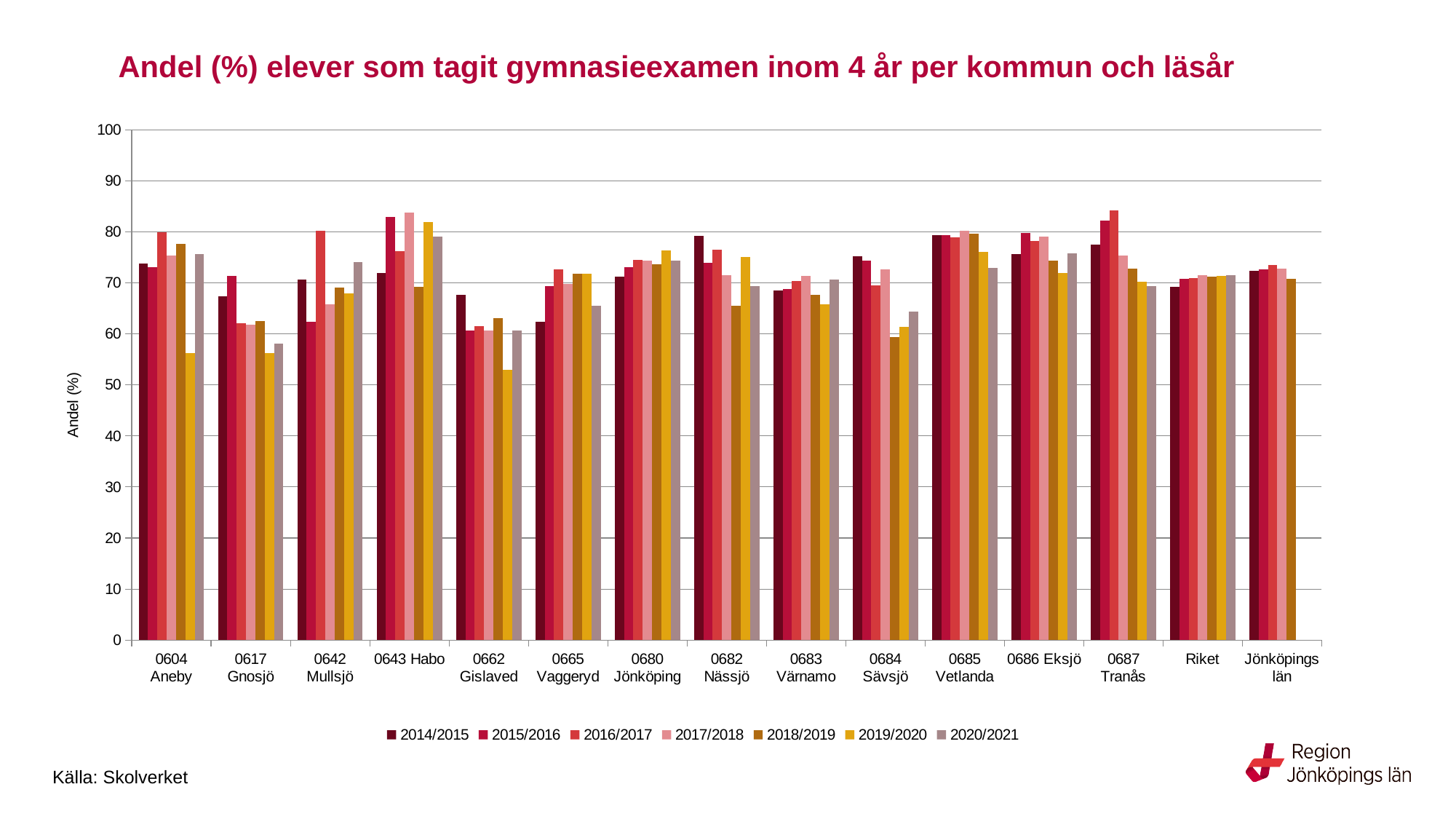
Is the value for 0662 Gislaved in 2019/2020 greater or less than 60? less Which category and school year has the lowest bar in the chart? 0662 Gislaved, 2019/2020 For 2016/2017, which is larger: the value for 0643 Habo or for 0662 Gislaved? 0643 Habo Is the value for 0684 Sävsjö in 2020/2021 greater or less than 60? greater What kind of chart is shown on the slide? Bar chart How many series does the legend list? 7 How many categories are shown along the x axis? 15 Is the value for 0604 Aneby in 2019/2020 greater or less than 60? less What is the label on the y axis? Andel (%) Do the values for 0617 Gnosjö generally rise or fall from 2014/2015 to 2020/2021? fall